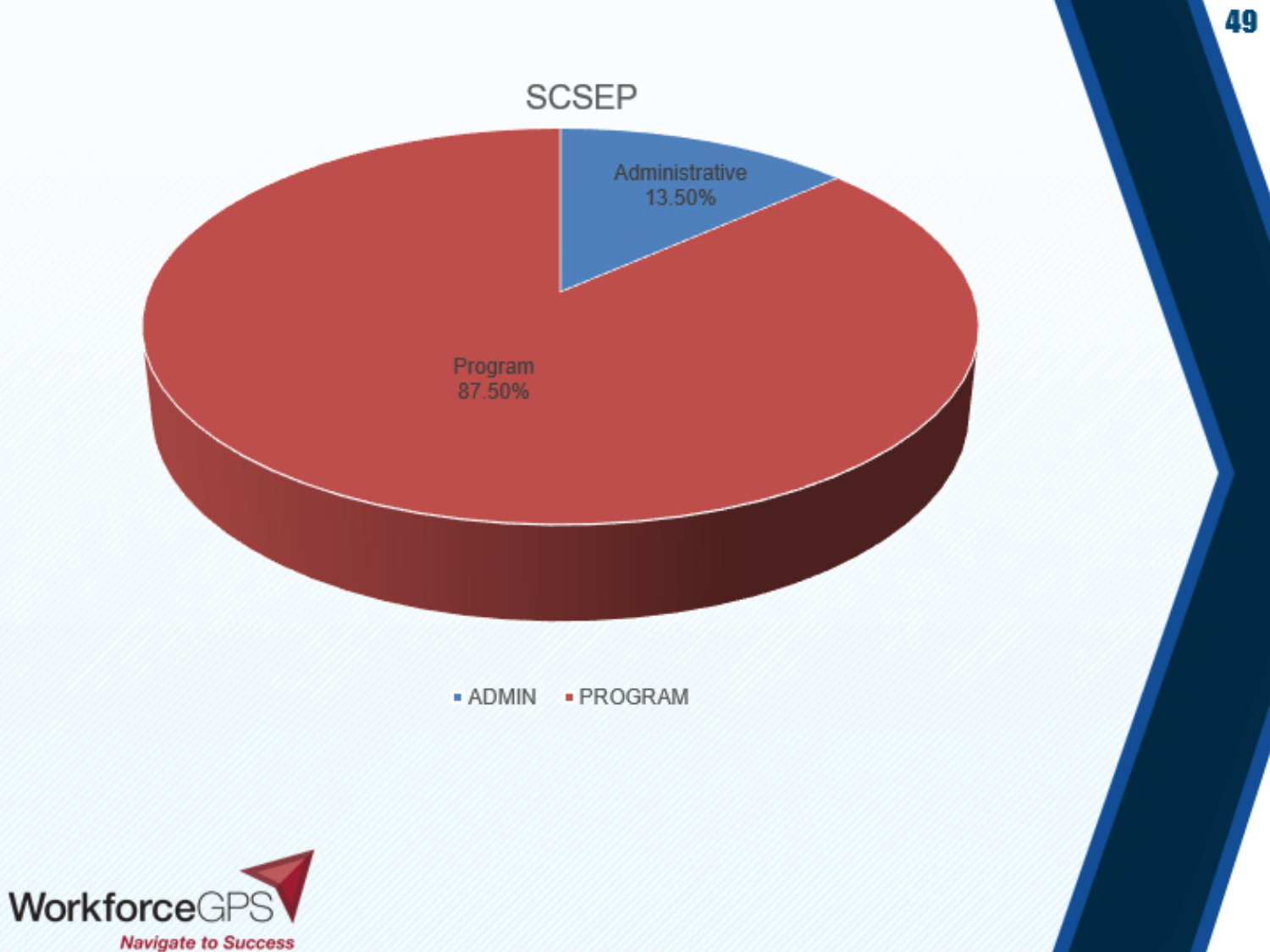
Which slice is the largest? Program What colour is the ADMIN slice in the legend? Blue Which is larger, the Program slice or the Administrative slice? Program What is the difference in percentage points between the Program and Administrative slices? 74 percentage points What kind of chart is shown on the slide? Pie chart What share of the pie does the Administrative slice represent? 13.50% How many entries does the legend list? 2 What share of the pie does the Program slice represent? 87.50% Which slice is the smallest? Administrative What is the title of the chart? SCSEP How many slices does the pie chart have? 2